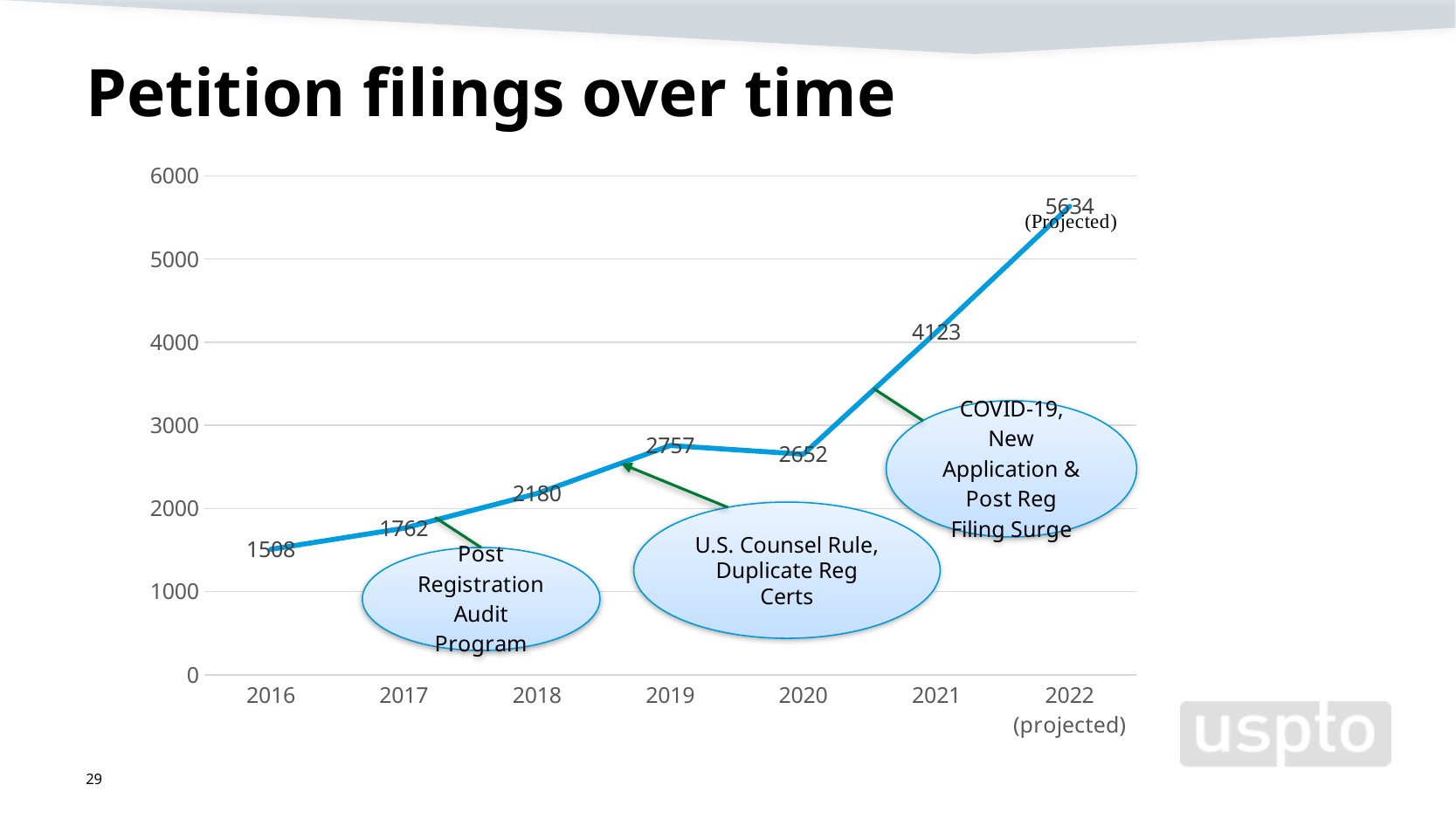
What is the title of the chart? Petition filings over time Which year has the highest value? 2022 (projected) What is the value for 2016? 1508 Is the value for 2017 greater or less than 2000? less Which year has the lowest value? 2016 Which is larger, the value for 2019 or the value for 2020? 2019 What is the value for 2021? 4123 What is the value for 2018? 2180 What is the projected value for 2022? 5634 What is the difference between the values for 2021 and 2020? 1471 How many years are plotted on the x axis? 7 What kind of chart is shown on the slide? line chart